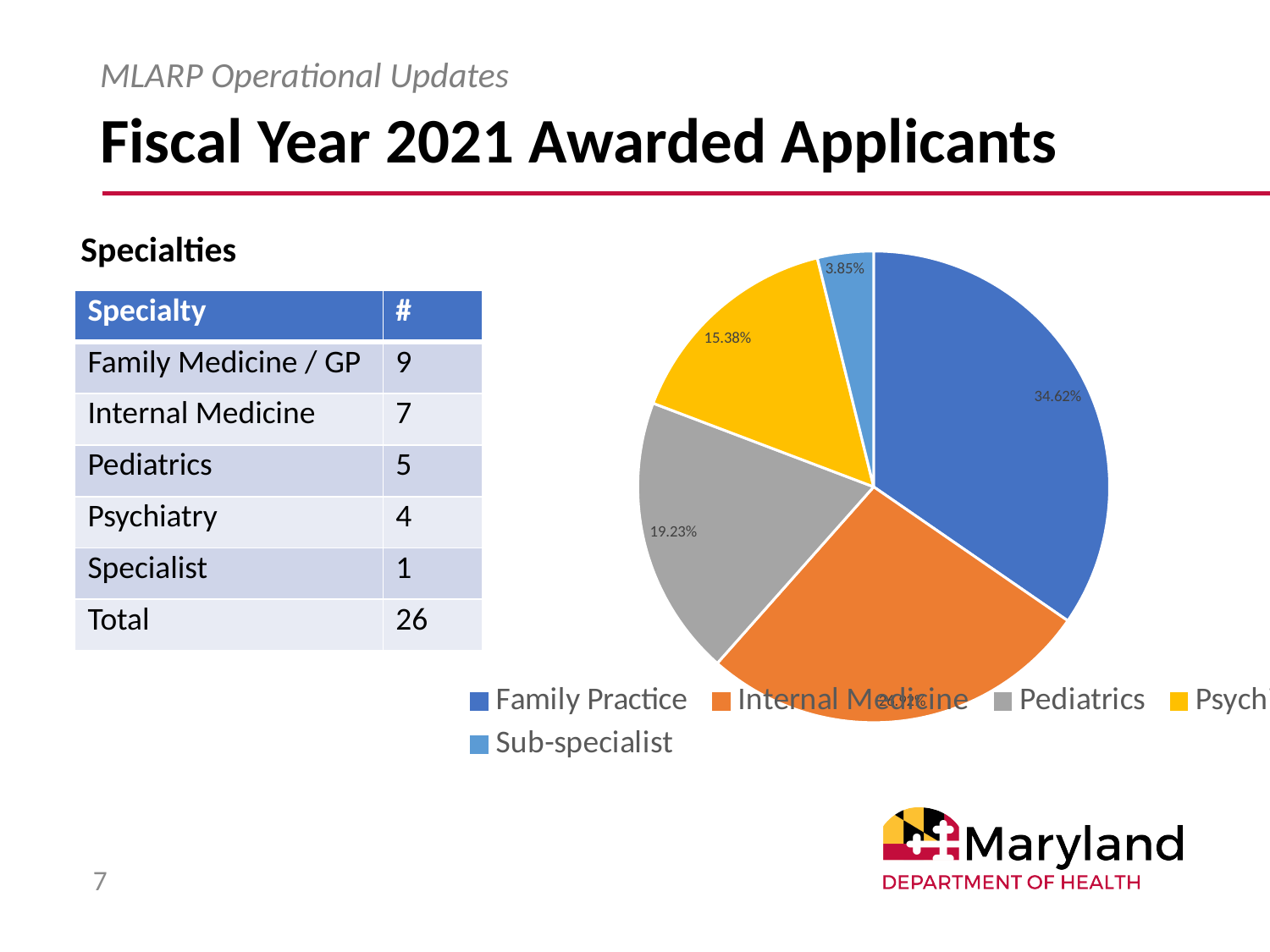
What share of the pie does the Pediatrics slice represent? 19.23% What colour is the Family Practice slice in the pie chart? blue What percentage is labelled on the yellow slice of the pie chart? 15.38% How many entries does the legend of the pie chart list? 5 What kind of chart is shown on the slide? pie chart What share of the pie does the Family Practice slice represent? 34.62% What share of the pie does the Sub-specialist slice represent? 3.85% What is the difference in percentage points between the Family Practice slice and the Pediatrics slice? 15.39 Which category has the largest slice of the pie chart? Family Practice Which slice is larger, Pediatrics or Sub-specialist? Pediatrics How many slices does the pie chart have? 5 Which category has the smallest slice of the pie chart? Sub-specialist